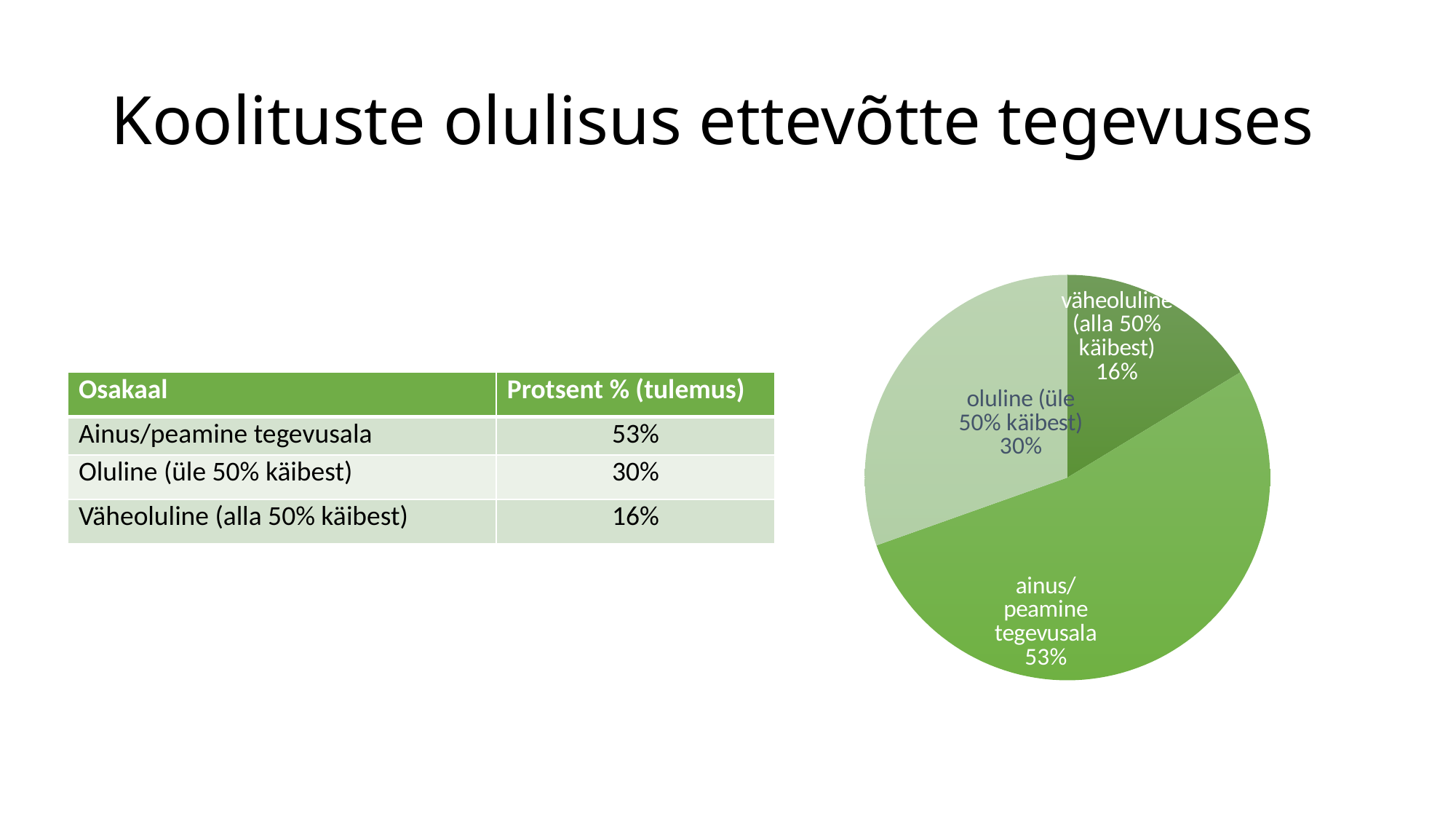
Which is larger in the pie chart: 'oluline (üle 50% käibest)' or 'väheoluline (alla 50% käibest)'? oluline (üle 50% käibest) What share of the pie does 'ainus/peamine tegevusala' have? 53% Which slice of the pie chart is the smallest? väheoluline (alla 50% käibest) What is the difference between the 'oluline (üle 50% käibest)' slice and the 'väheoluline (alla 50% käibest)' slice? 14% What share of the pie does 'oluline (üle 50% käibest)' have? 30% Is the share for 'ainus/peamine tegevusala' greater or less than 50%? greater What is the difference between the 'ainus/peamine tegevusala' slice and the 'oluline (üle 50% käibest)' slice? 23% What kind of chart is shown on the slide? pie chart What share of the pie does 'väheoluline (alla 50% käibest)' have? 16% What is the title of the slide containing the pie chart? Koolituste olulisus ettevõtte tegevuses Which slice of the pie chart is the largest? ainus/peamine tegevusala How many slices does the pie chart have? 3